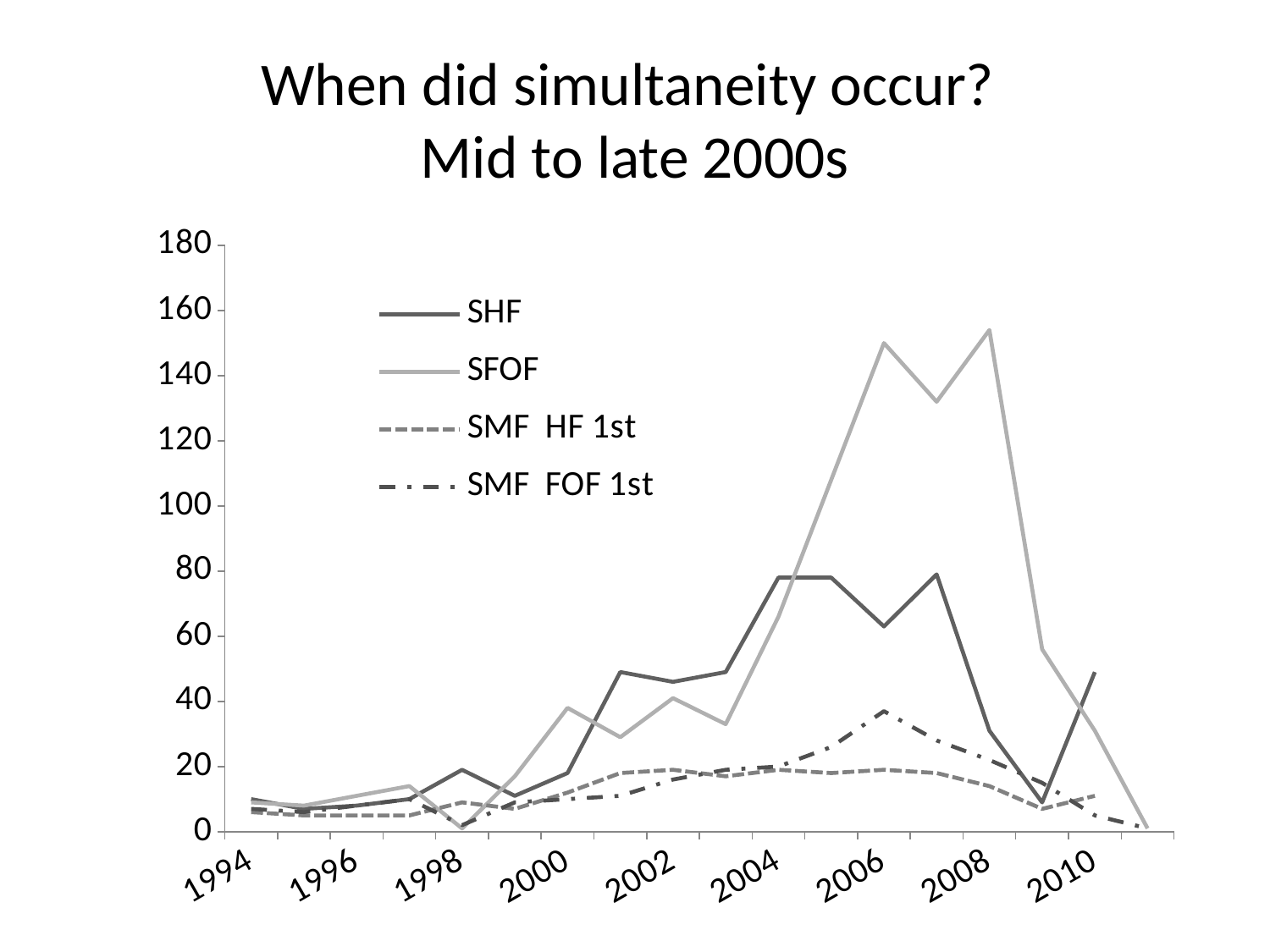
Is the value for SMF FOF 1st in 2006 greater or less than 20? greater Which series has the lowest value in 2006? SMF HF 1st Which series is drawn with a dash-dot line? SMF FOF 1st Which series reaches the highest value anywhere on the chart? SFOF What kind of chart is shown on the slide? line chart In 2006, which is larger: SFOF or SHF? SFOF Is the value for SHF in 1998 greater or less than 40? less Is the value for SHF in 2004 greater or less than 60? greater Does the SFOF line rise or fall between 2008 and 2010? fall In 2000, which is larger: SFOF or SHF? SFOF How many series does the legend list? 4